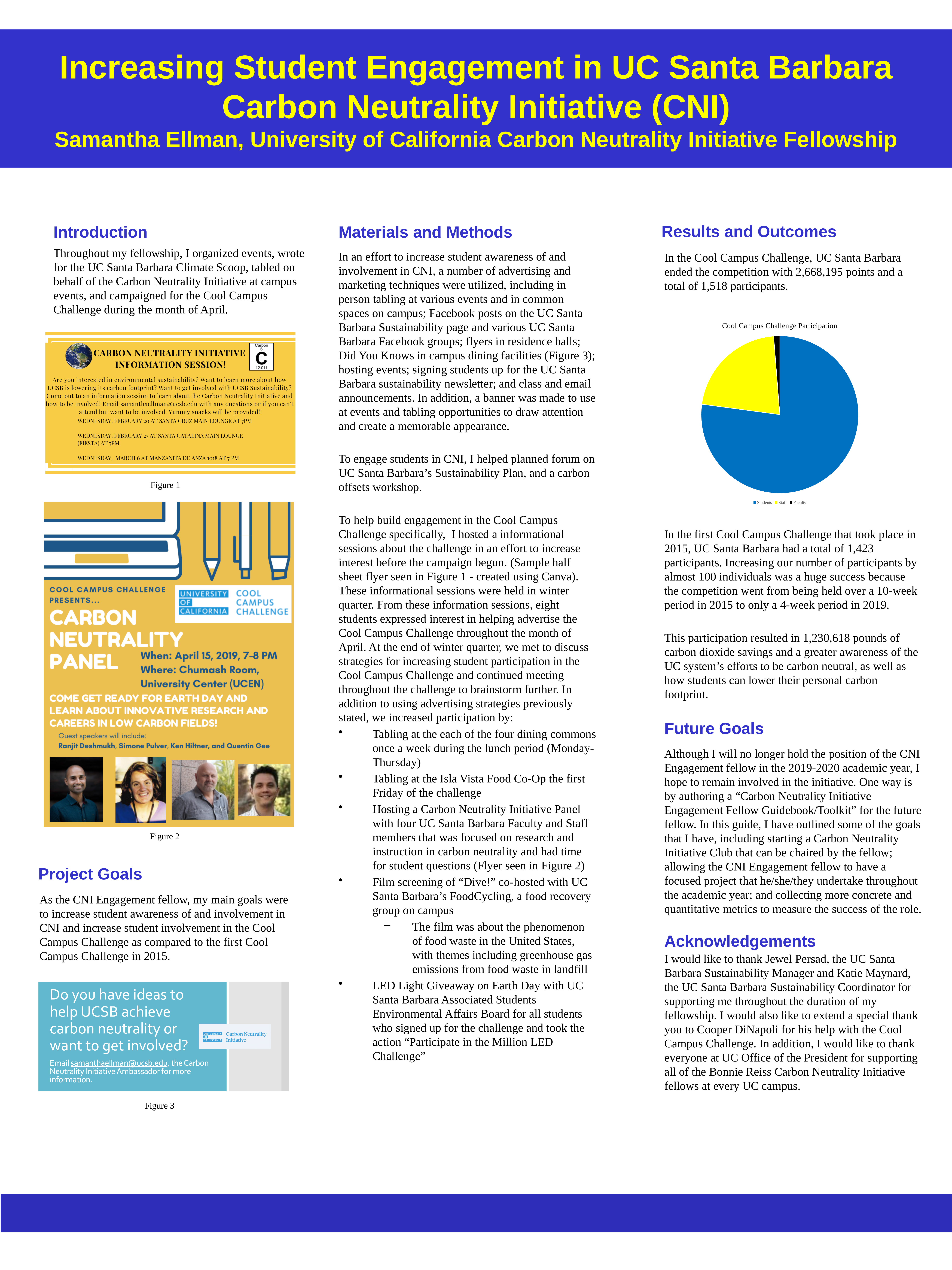
In the Cool Campus Challenge Participation pie chart, which slice is larger, Students or Staff? Students Which category has the smallest slice in the Cool Campus Challenge Participation pie chart? Faculty What colour represents Staff in the Cool Campus Challenge Participation pie chart? yellow How many categories does the legend of the Cool Campus Challenge Participation pie chart list? 3 In the Cool Campus Challenge Participation pie chart, which slice is larger, Staff or Faculty? Staff What is the title of the pie chart? Cool Campus Challenge Participation What kind of chart is shown under Results and Outcomes? pie chart Which category has the largest slice in the Cool Campus Challenge Participation pie chart? Students How many slices does the Cool Campus Challenge Participation pie chart have? 3